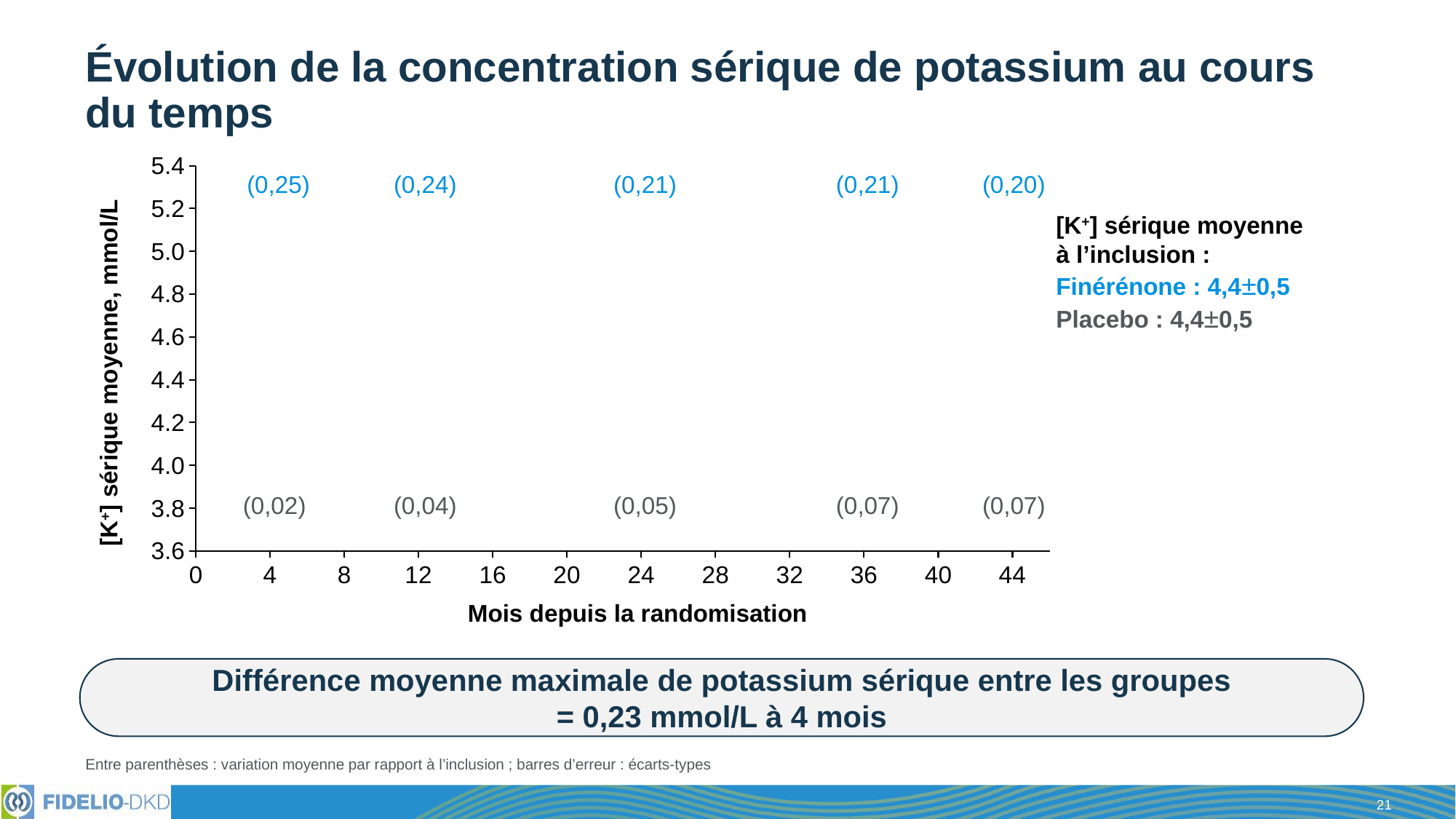
What is the mean serum [K+] at inclusion for the Finérénone group, as stated next to the chart? 4,4±0,5 What is the title of the chart's y axis? [K+] sérique moyenne, mmol/L What is the blue annotation value shown above the chart at 4 months? (0,25) At which month is the grey annotation value the lowest? 4 How many blue annotation values are shown along the top of the chart? 5 What is the grey annotation value shown at 4 months? (0,02) What is the grey annotation value shown near the bottom of the chart at 36 months? (0,07) What is the blue annotation value shown at 44 months? (0,20) Do the blue annotation values rise or fall from 4 months to 44 months? fall What is the difference between the blue annotation value and the grey annotation value at 4 months? 0,23 At which month is the blue annotation value the highest? 4 What is the label of the x axis? Mois depuis la randomisation